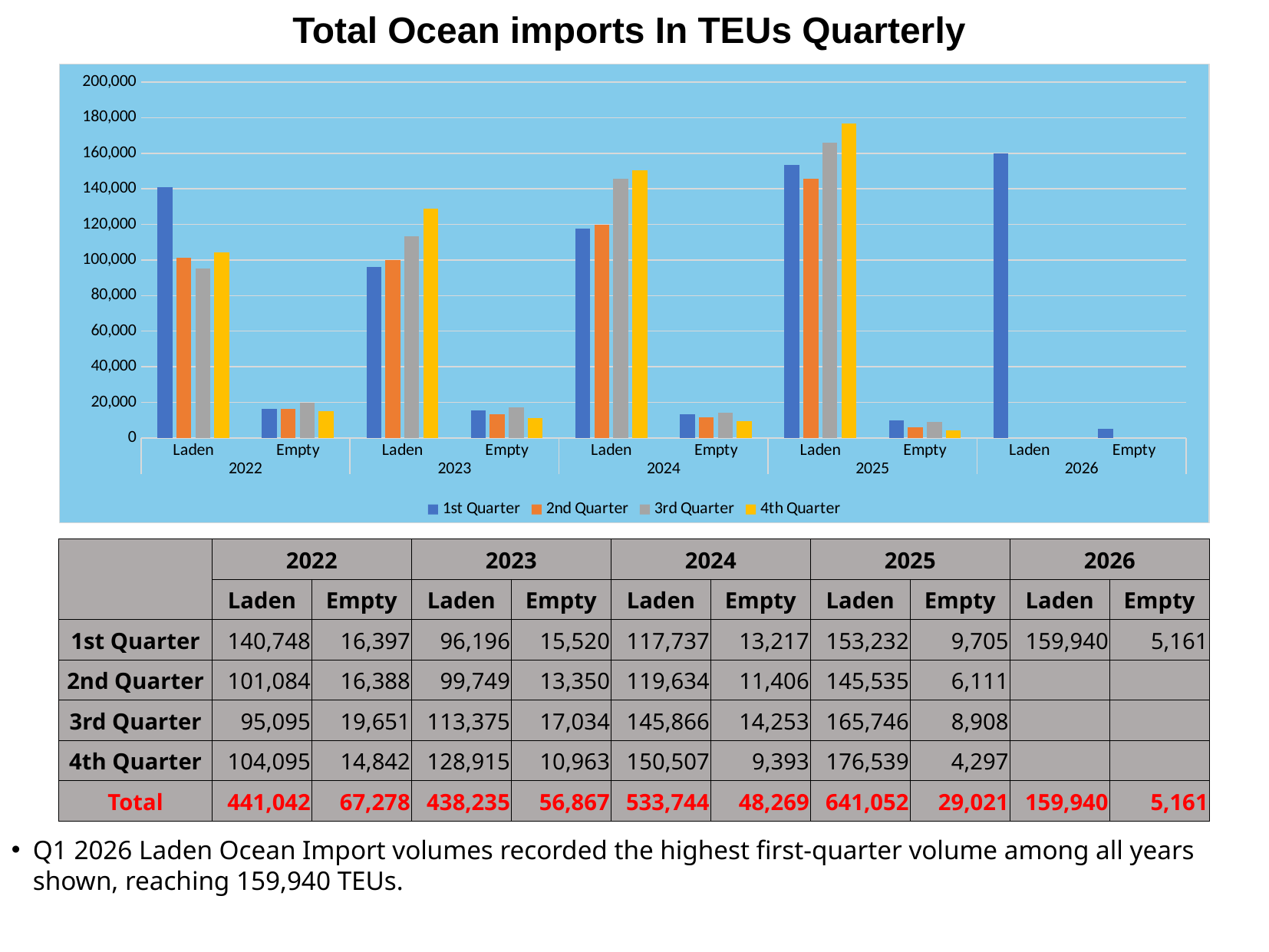
What is the difference between the 4th Quarter and 1st Quarter Laden values for 2024? 32,770 What colour represents the 4th Quarter in the chart legend? yellow Which is larger, the 1st Quarter Laden value for 2022 or for 2023? 2022 Is the 4th Quarter Laden value for 2023 greater or less than 120,000? greater How many years are shown on the x axis of the chart? 5 How many series does the chart legend list? 4 Which quarter has the lowest Empty value in 2025? 4th Quarter What kind of chart is shown on the slide? bar chart Which quarter and year has the highest Laden value in the chart? 4th Quarter 2025 Do the Laden values rise or fall from the 1st Quarter to the 4th Quarter in 2024? rise What is the 4th Quarter Laden value for 2025? 176,539 What is the 1st Quarter Laden value for 2022? 140,748